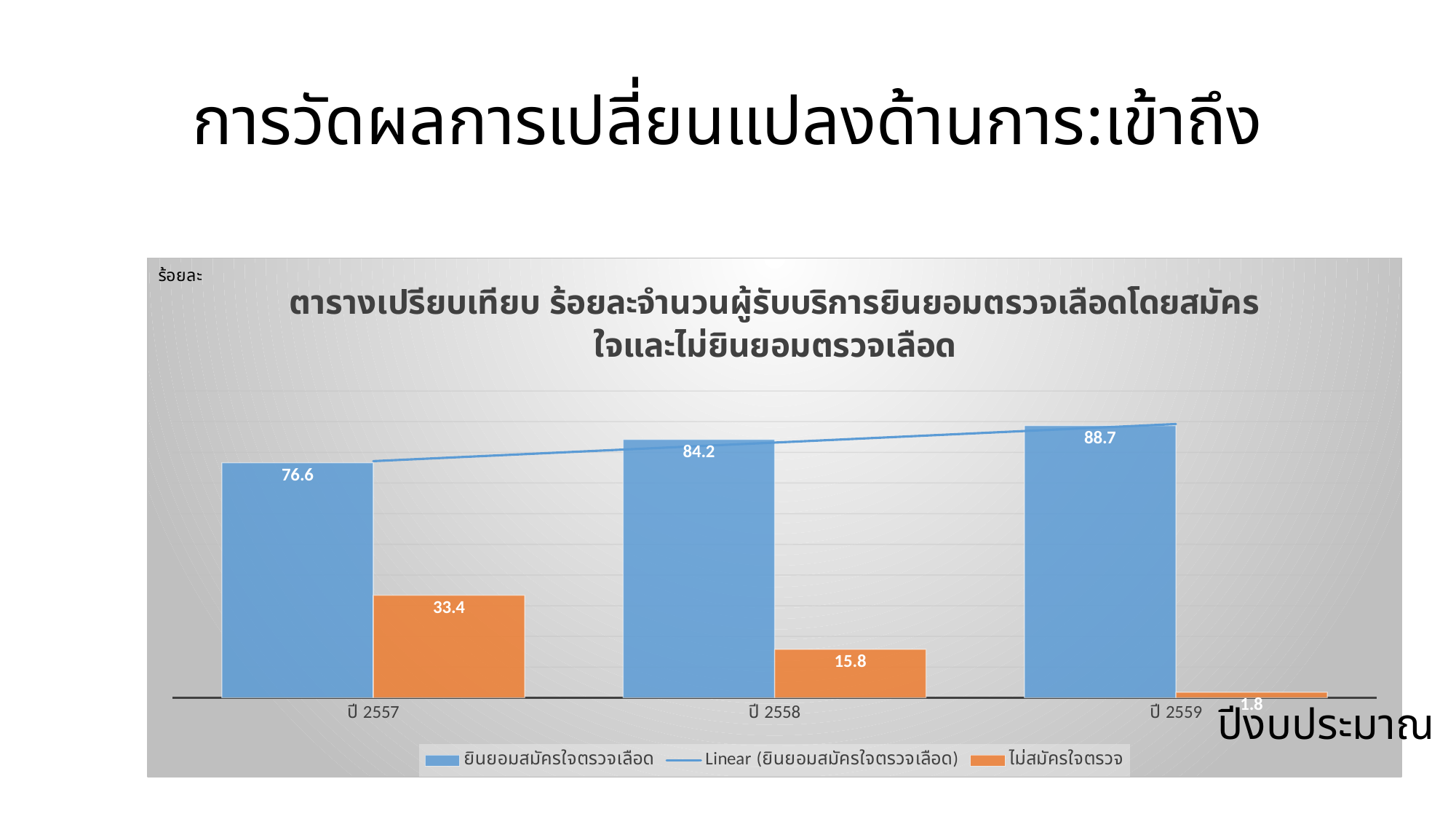
In which year is the value for ยินยอมสมัครใจตรวจเลือด highest? ปี 2559 What is the difference between the ไม่สมัครใจตรวจ values for ปี 2557 and ปี 2558? 17.6 In which year is the value for ไม่สมัครใจตรวจ lowest? ปี 2559 How many years are shown on the x axis? 3 What is the value for ยินยอมสมัครใจตรวจเลือด in ปี 2557? 76.6 Which is larger in ปี 2558: ยินยอมสมัครใจตรวจเลือด or ไม่สมัครใจตรวจ? ยินยอมสมัครใจตรวจเลือด How many entries does the legend list? 3 What is the value for ไม่สมัครใจตรวจ in ปี 2558? 15.8 What is the value for ไม่สมัครใจตรวจ in ปี 2559? 1.8 What is the value for ยินยอมสมัครใจตรวจเลือด in ปี 2559? 88.7 Does the value for ยินยอมสมัครใจตรวจเลือด rise or fall from ปี 2557 to ปี 2559? rise What is the difference between the ยินยอมสมัครใจตรวจเลือด values for ปี 2559 and ปี 2557? 12.1